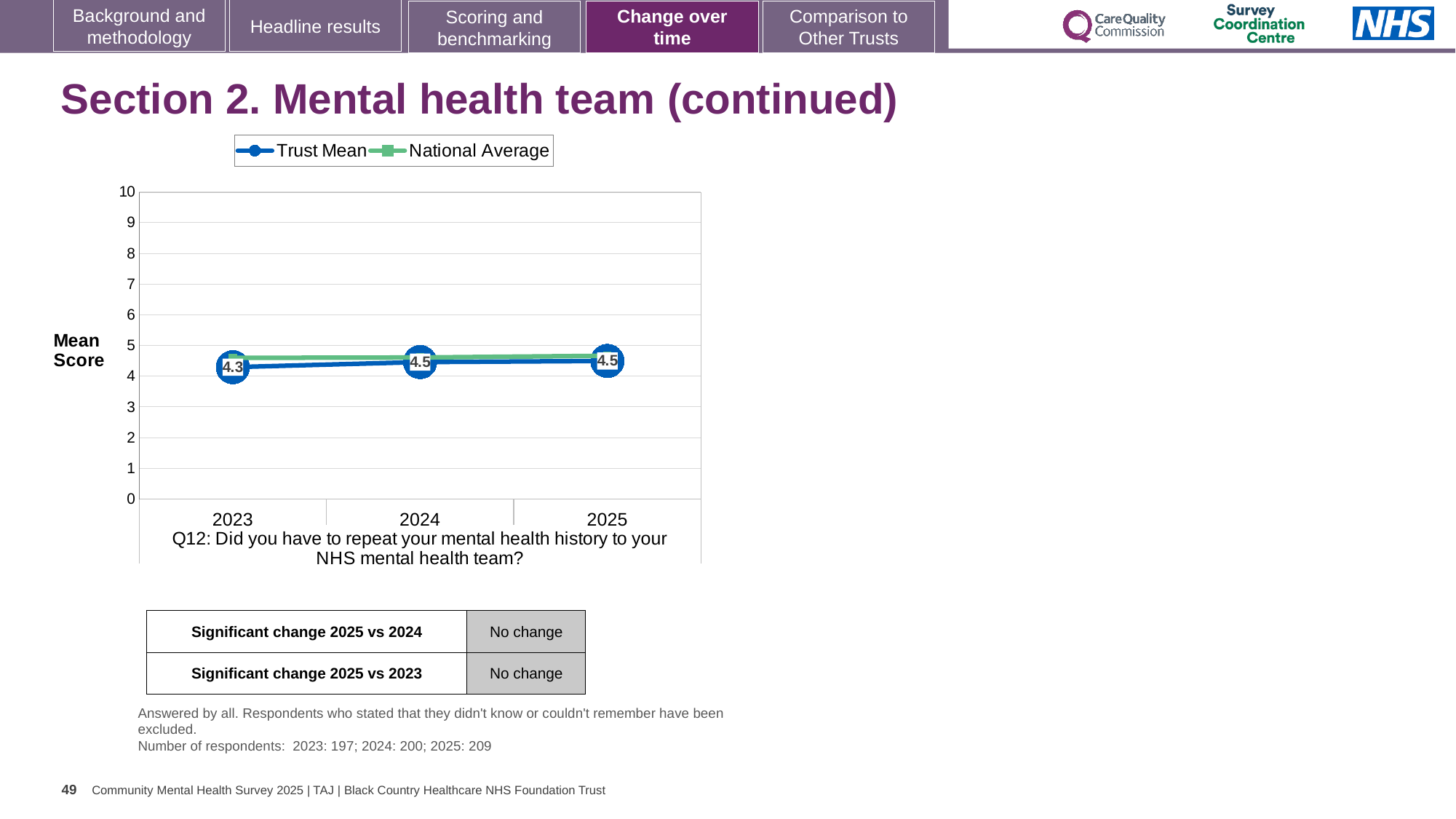
Is the National Average value for 2023 greater or less than 5? less What is the Trust Mean score for 2024? 4.5 What kind of chart is shown on the slide? Line chart How many years are plotted on the x axis? 3 In which year is the Trust Mean score lowest? 2023 How many series does the legend list? 2 What is the Trust Mean score for 2025? 4.5 Is the National Average value for 2025 greater or less than 4? greater What is the difference between the Trust Mean score in 2025 and in 2023? 0.2 What is the Trust Mean score for 2023? 4.3 Is the Trust Mean score for 2024 larger than the Trust Mean score for 2023? Yes Does the Trust Mean score rise or fall from 2023 to 2024? Rise